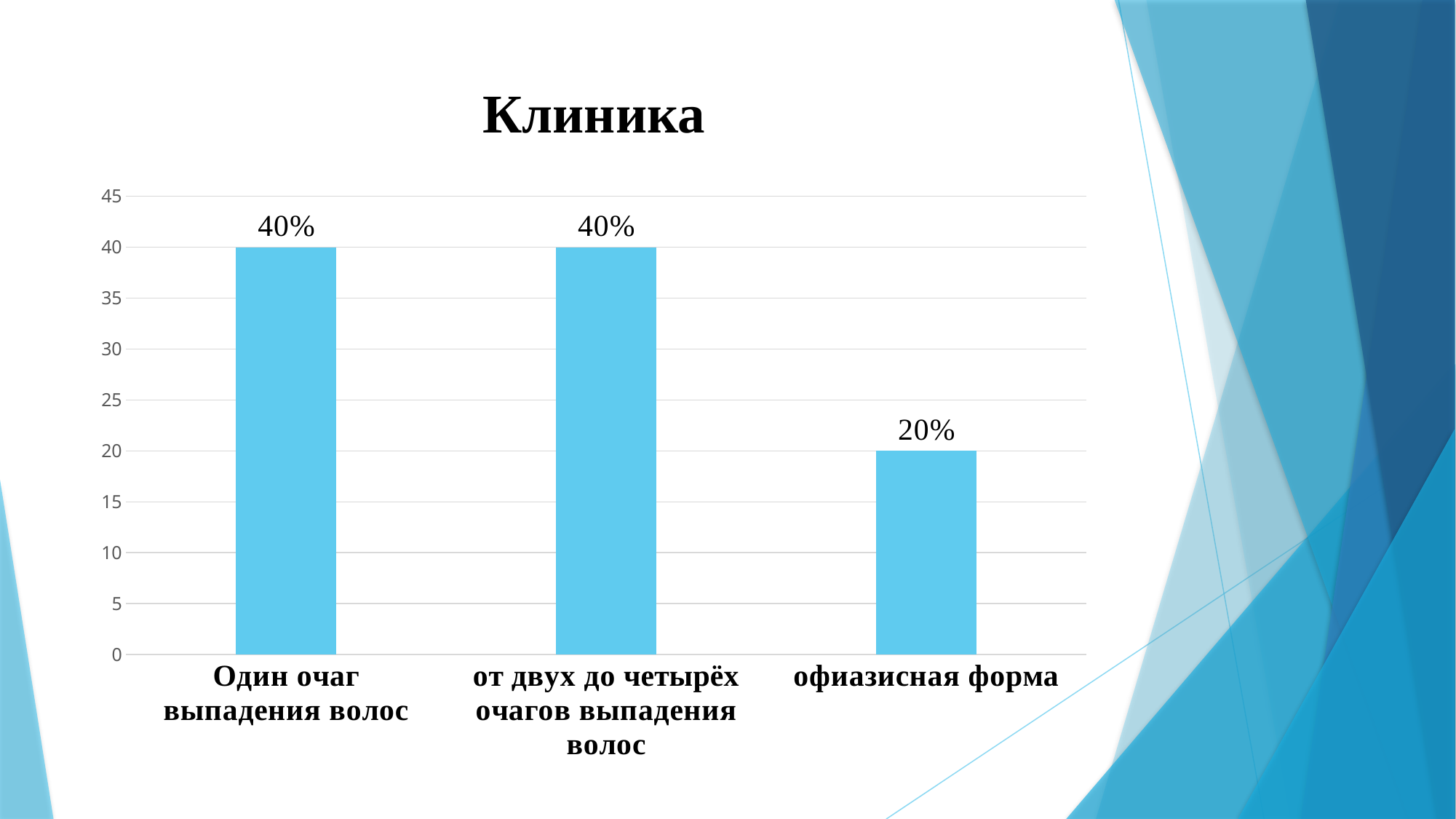
Is the value for "Один очаг выпадения волос" greater or less than 35? greater Which category has the lowest value? офиазисная форма What is the value for "Один очаг выпадения волос"? 40% Which is larger: the value for "от двух до четырёх очагов выпадения волос" or the value for "офиазисная форма"? от двух до четырёх очагов выпадения волос What is the difference between the values for "Один очаг выпадения волос" and "офиазисная форма"? 20% What is the title of the slide? Клиника What is the highest value shown on the vertical axis? 45 What is the value for "офиазисная форма"? 20% What kind of chart is shown on the slide? bar chart Is the value for "офиазисная форма" greater or less than 30? less What is the value for "от двух до четырёх очагов выпадения волос"? 40% How many categories are shown in the chart? 3